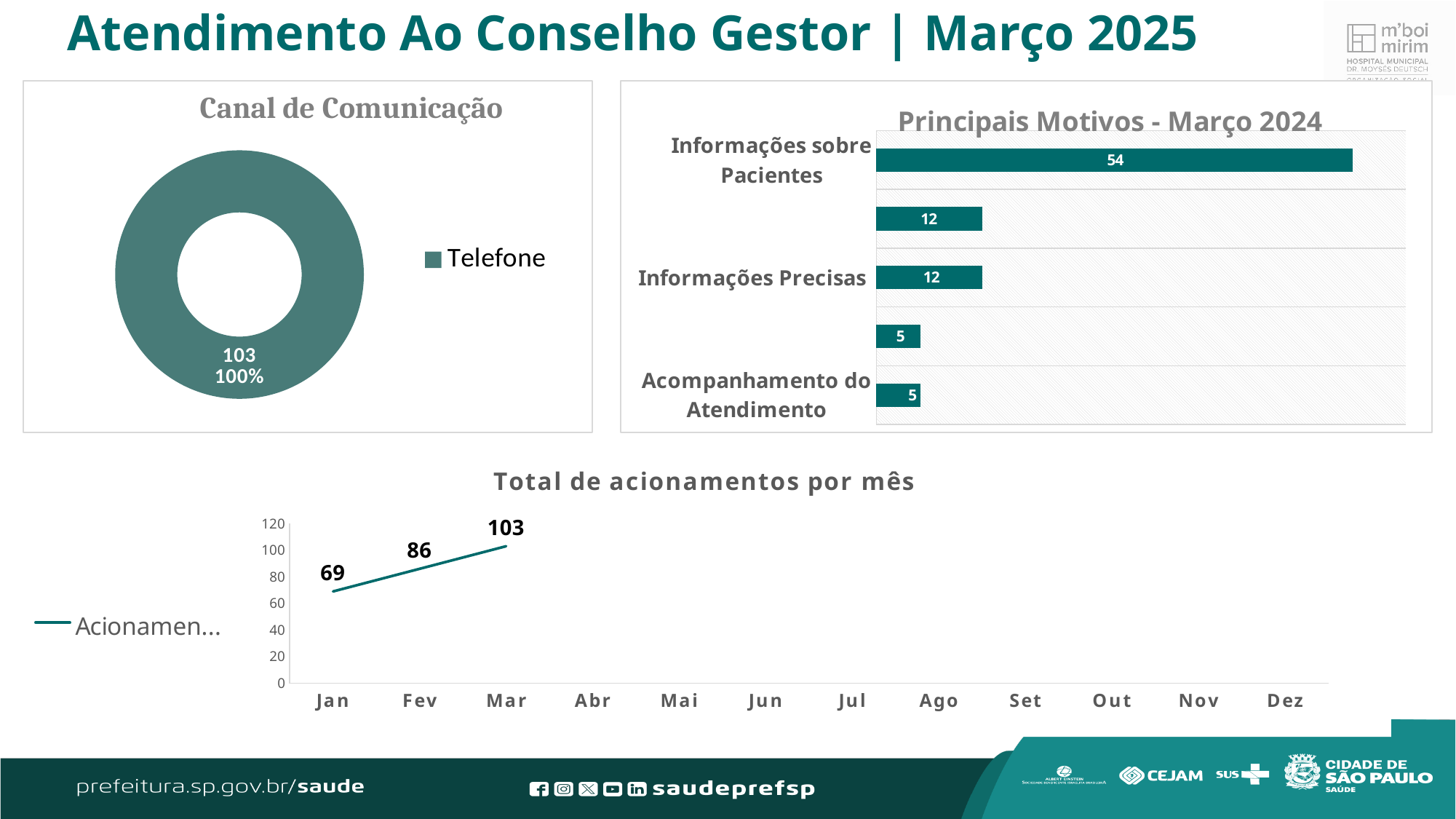
In the 'Canal de Comunicação' chart, what value is shown for Telefone? 103 In the 'Principais Motivos - Março 2024' chart, what is the difference between Informações sobre Pacientes and Informações Precisas? 42 How many bars are plotted in the 'Principais Motivos - Março 2024' chart? 5 In the 'Total de acionamentos por mês' chart, what is the value for Fev? 86 In the 'Principais Motivos - Março 2024' chart, what is the value for Acompanhamento do Atendimento? 5 In the 'Total de acionamentos por mês' chart, what is the difference between Mar and Jan? 34 What kind of chart is 'Total de acionamentos por mês'? Line chart In the 'Total de acionamentos por mês' chart, do the values rise or fall from Jan to Mar? Rise In the 'Principais Motivos - Março 2024' chart, which category has the highest value? Informações sobre Pacientes What kind of chart is 'Canal de Comunicação'? Pie (donut) chart In the 'Principais Motivos - Março 2024' chart, what is the value for Informações sobre Pacientes? 54 In the 'Canal de Comunicação' chart, what share of the total does Telefone represent? 100%